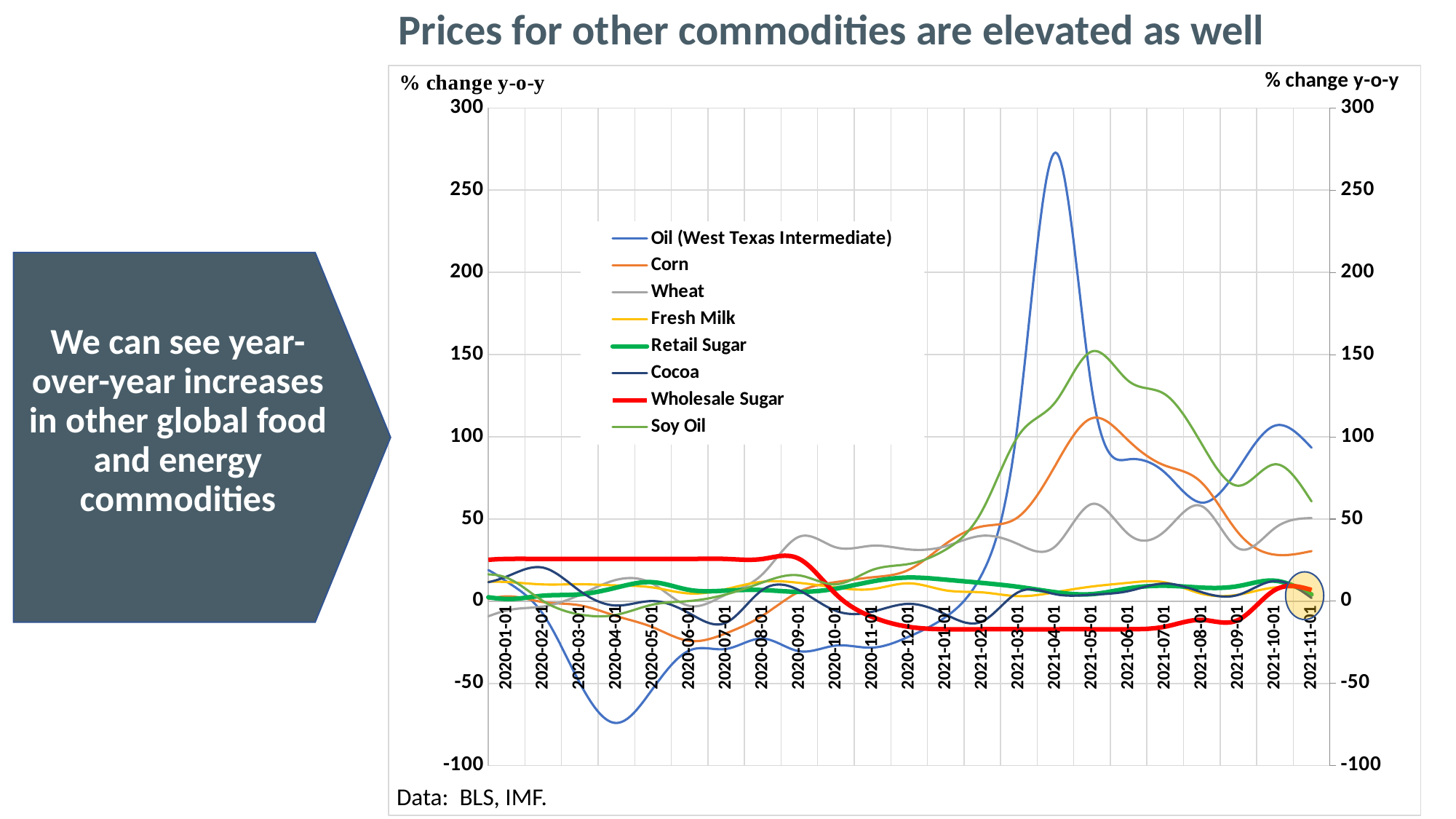
Is the value for Soy Oil at 2021-05-01 greater or less than 100? greater How many monthly dates are labelled on the x axis? 23 Is the value for Wholesale Sugar at 2021-03-01 greater or less than 0? less Is the value for Oil (West Texas Intermediate) at 2020-04-01 greater or less than -50? less Does the Oil (West Texas Intermediate) line rise or fall between 2020-04-01 and 2021-04-01? rise Which series reaches the highest peak on the chart? Oil (West Texas Intermediate) Which series falls to the lowest value on the chart? Oil (West Texas Intermediate) How many series does the legend list? 8 What kind of chart is shown on the slide? line chart At 2021-04-01, which is larger: Oil (West Texas Intermediate) or Corn? Oil (West Texas Intermediate) What is the title of the chart? Prices for other commodities are elevated as well